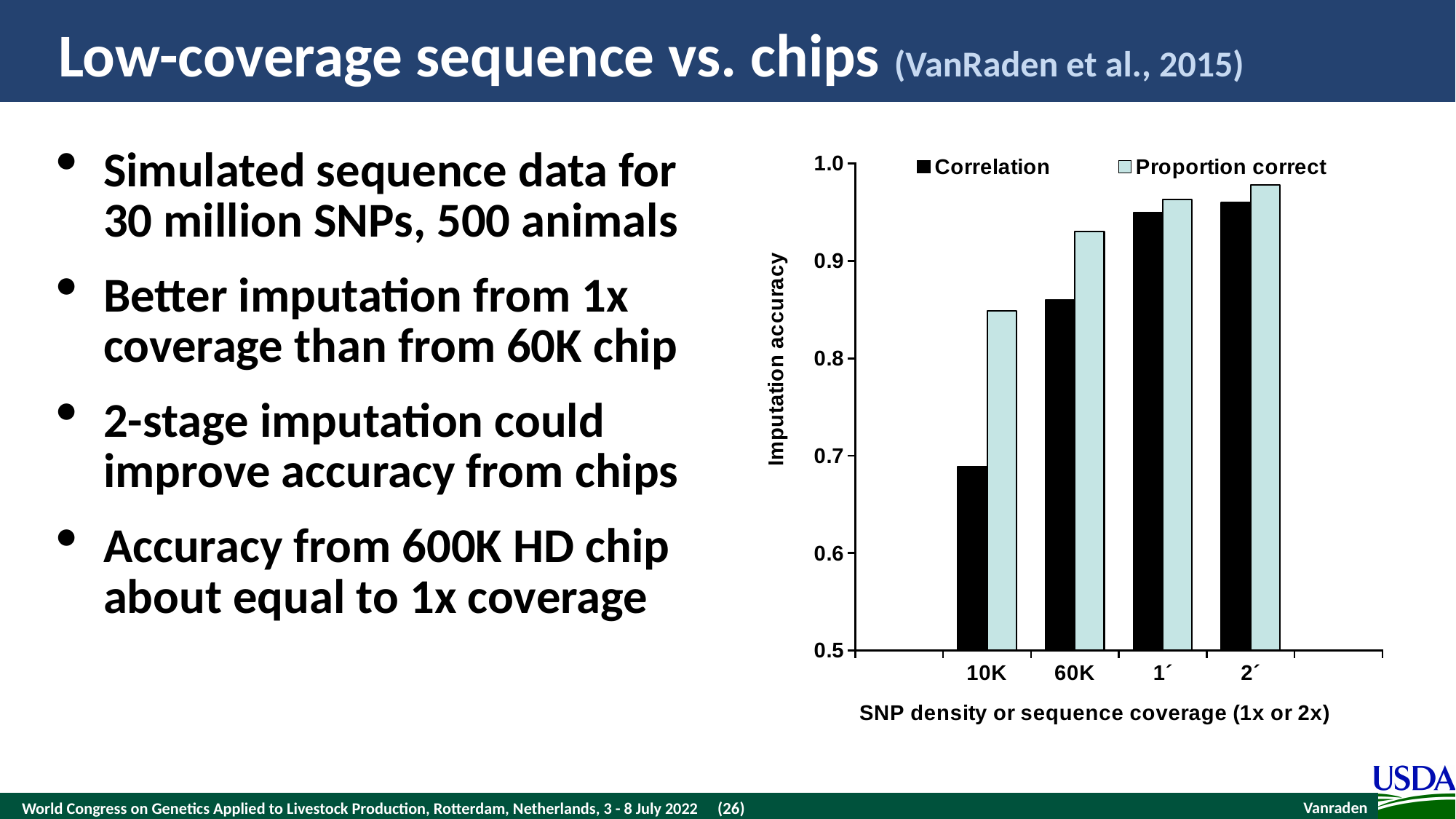
Is the Correlation value for 1x greater or less than 0.9? greater Which category has the lowest Correlation value? 10K What kind of chart is shown on the slide? bar chart What is the title of the chart's y axis? Imputation accuracy Is the Correlation value for 10K greater or less than 0.8? less Do the Correlation values rise or fall moving from 10K to 2x along the x axis? rise Is the Proportion correct value for 60K greater or less than 0.9? greater Which category has the highest Proportion correct value? 2x How many series does the chart's legend list? 2 At 10K, which is larger: Correlation or Proportion correct? Proportion correct How many categories are shown on the x axis of the chart? 4